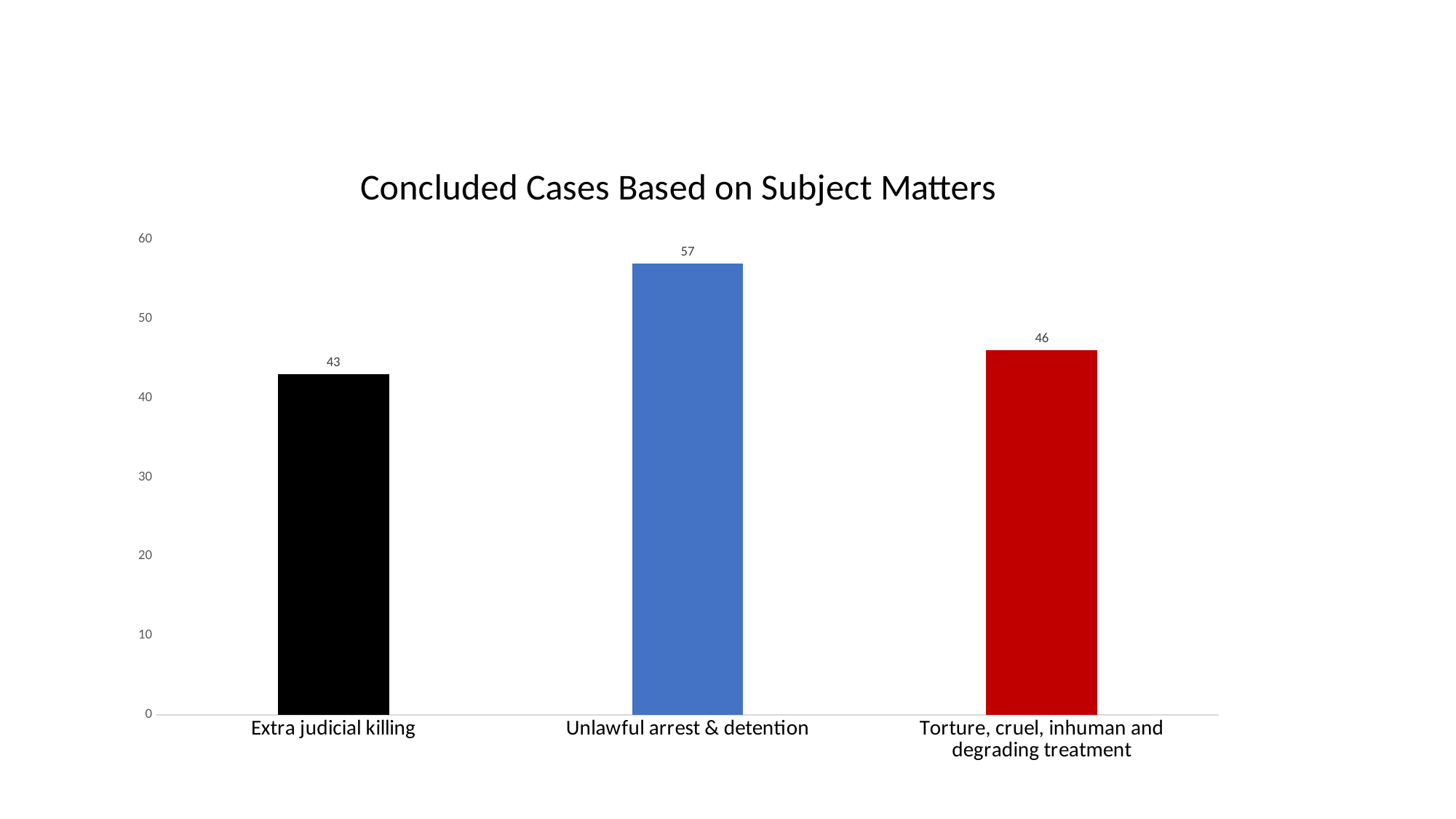
Which category has the lowest value? Extra judicial killing What is the difference between the values for Torture, cruel, inhuman and degrading treatment and Extra judicial killing? 3 What is the difference between the values for Unlawful arrest & detention and Extra judicial killing? 14 What is the title of the chart? Concluded Cases Based on Subject Matters Which category has the highest value? Unlawful arrest & detention What is the value for Extra judicial killing? 43 What is the value for Unlawful arrest & detention? 57 How many categories are shown in the chart? 3 What kind of chart is shown on the slide? bar chart Which is larger, the value for Unlawful arrest & detention or the value for Torture, cruel, inhuman and degrading treatment? Unlawful arrest & detention What is the value for Torture, cruel, inhuman and degrading treatment? 46 Is the value for Extra judicial killing greater or less than 50? less